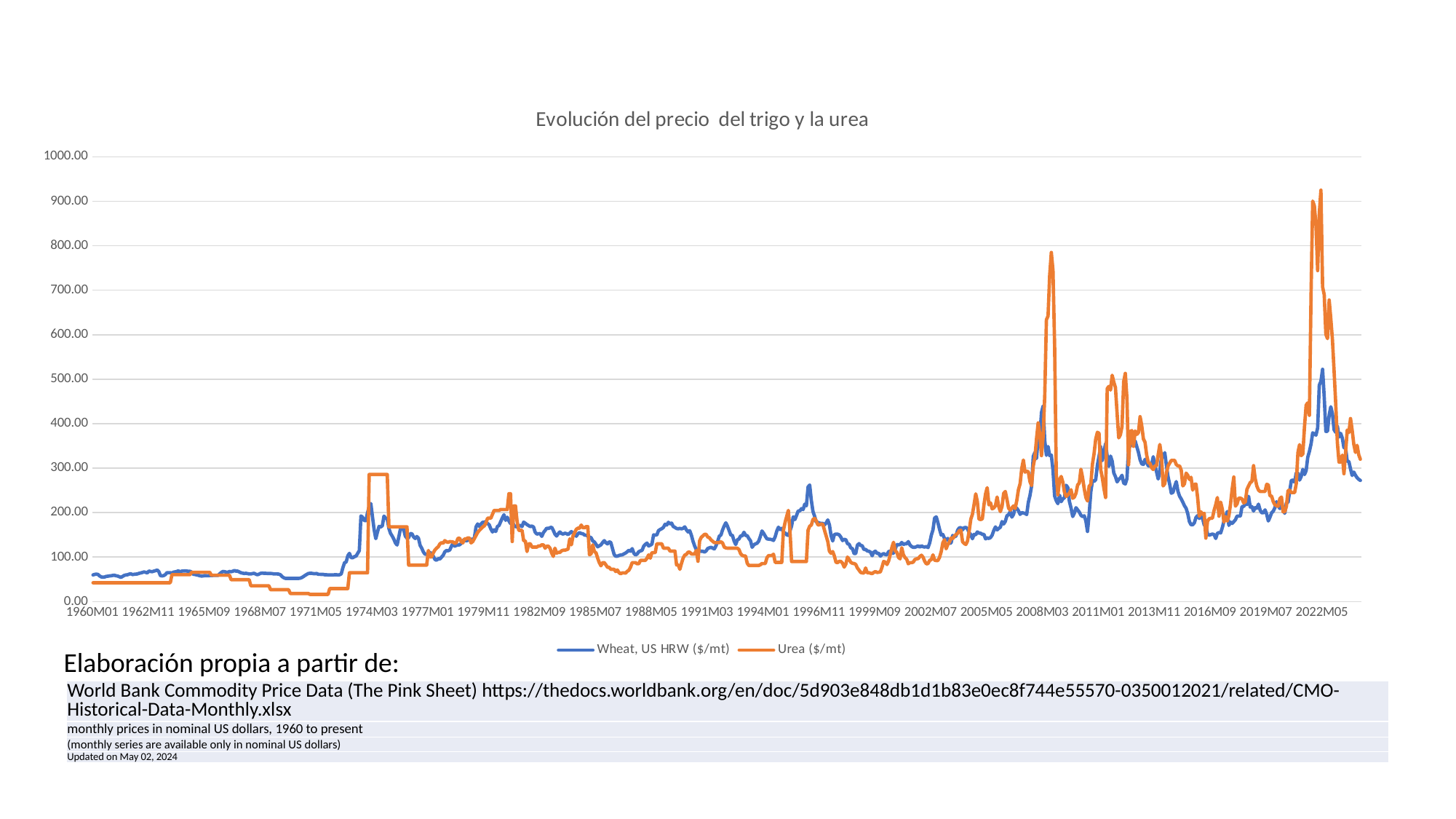
Which colour is used for the Urea ($/mt) series? Orange How many series does the legend list? 2 Overall, do the prices of wheat and urea rise or fall from 1960 to the end of the series? Rise Is the value of Wheat, US HRW ($/mt) at 1960M01 greater or less than 100? less Is the highest value of the Urea ($/mt) series greater or less than 800? greater Is the peak of Urea ($/mt) around 2008 greater or less than 700? greater Which series reaches the highest peak on the chart, Wheat, US HRW ($/mt) or Urea ($/mt)? Urea ($/mt) What kind of chart is shown on the slide? Line chart What is the title of the chart? Evolución del precio del trigo y la urea What is the maximum value shown on the vertical axis? 1000.00